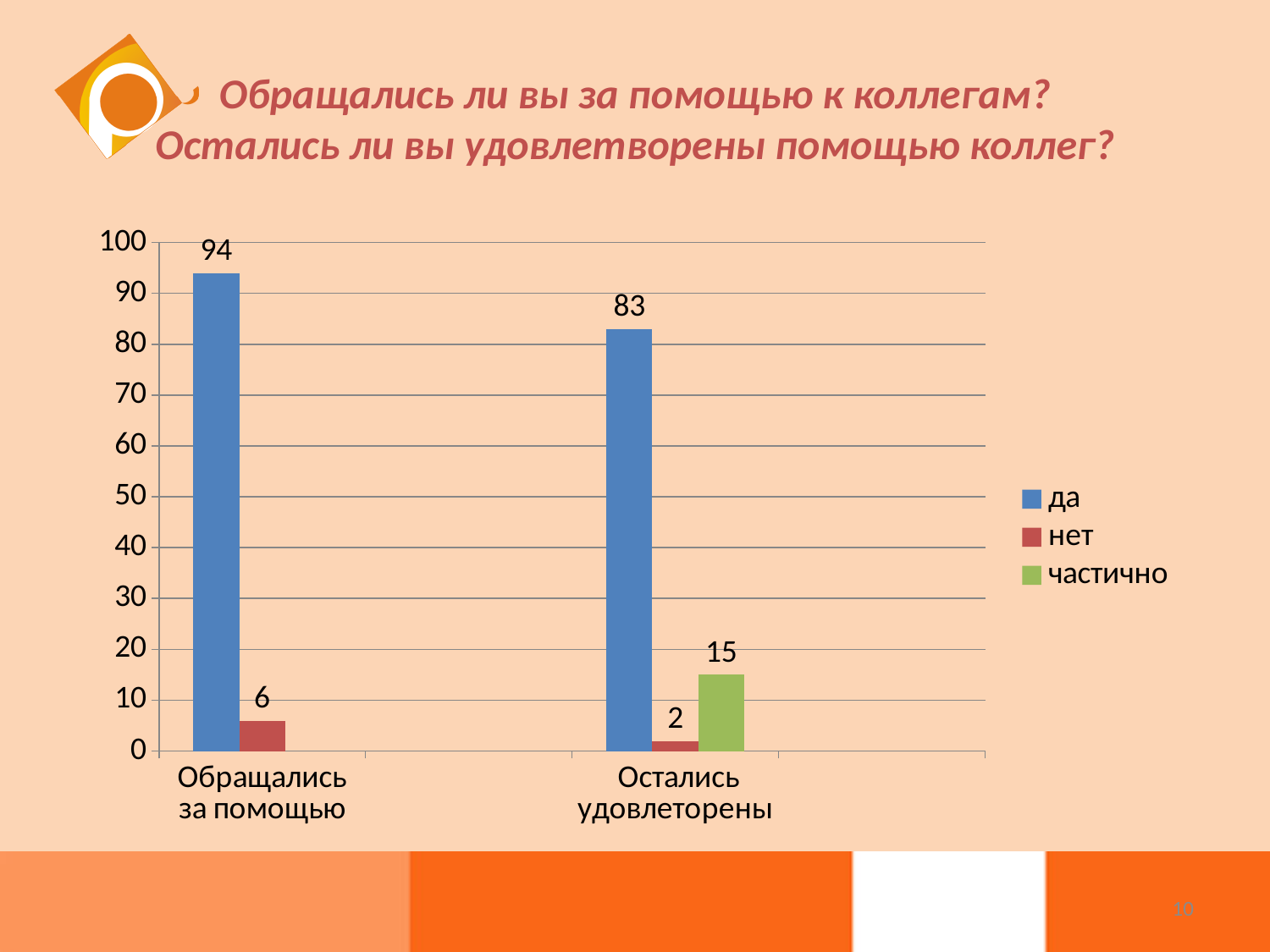
What kind of chart is shown on the slide? bar chart What is the difference between the "да" values for "Обращались за помощью" and "Остались удовлеторены"? 11 What is the value for "нет" in the "Обращались за помощью" category? 6 Which series has the lowest value in the "Остались удовлеторены" category? нет What is the value for "частично" in the "Остались удовлеторены" category? 15 Which series has the highest value in the "Остались удовлеторены" category? да How many series does the legend list? 3 What is the value for "да" in the "Обращались за помощью" category? 94 Which is larger: the "нет" value for "Обращались за помощью" or the "частично" value for "Остались удовлеторены"? частично for Остались удовлеторены What is the value for "нет" in the "Остались удовлеторены" category? 2 How many categories are shown on the x axis? 2 What colour represents the "частично" series in the legend? green